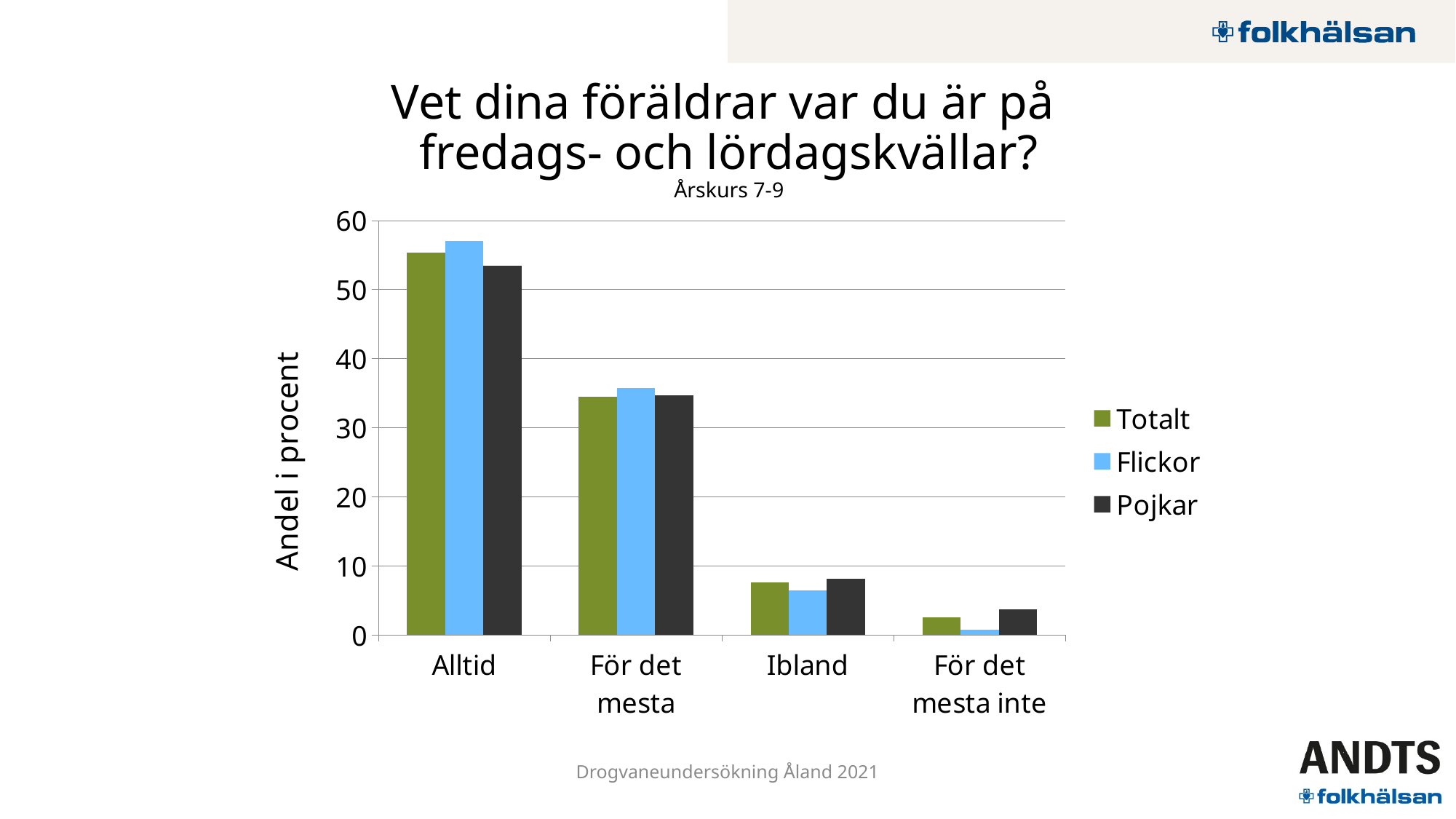
For the Pojkar series, which category has the lowest value? För det mesta inte Is the Pojkar value for För det mesta greater or less than 40? less How many categories are shown on the x axis of the chart? 4 Do the Totalt values rise or fall from Alltid to För det mesta inte along the x axis? fall Is the Totalt value for Alltid greater or less than 50? greater Is the Flickor value for Ibland greater or less than 10? less In the För det mesta inte category, which is larger: Pojkar or Flickor? Pojkar How many series does the legend list? 3 What is the label on the vertical axis of the chart? Andel i procent For the Flickor series, which category has the highest value? Alltid What kind of chart is shown on the slide? Bar chart In the Alltid category, which is larger: Flickor or Pojkar? Flickor